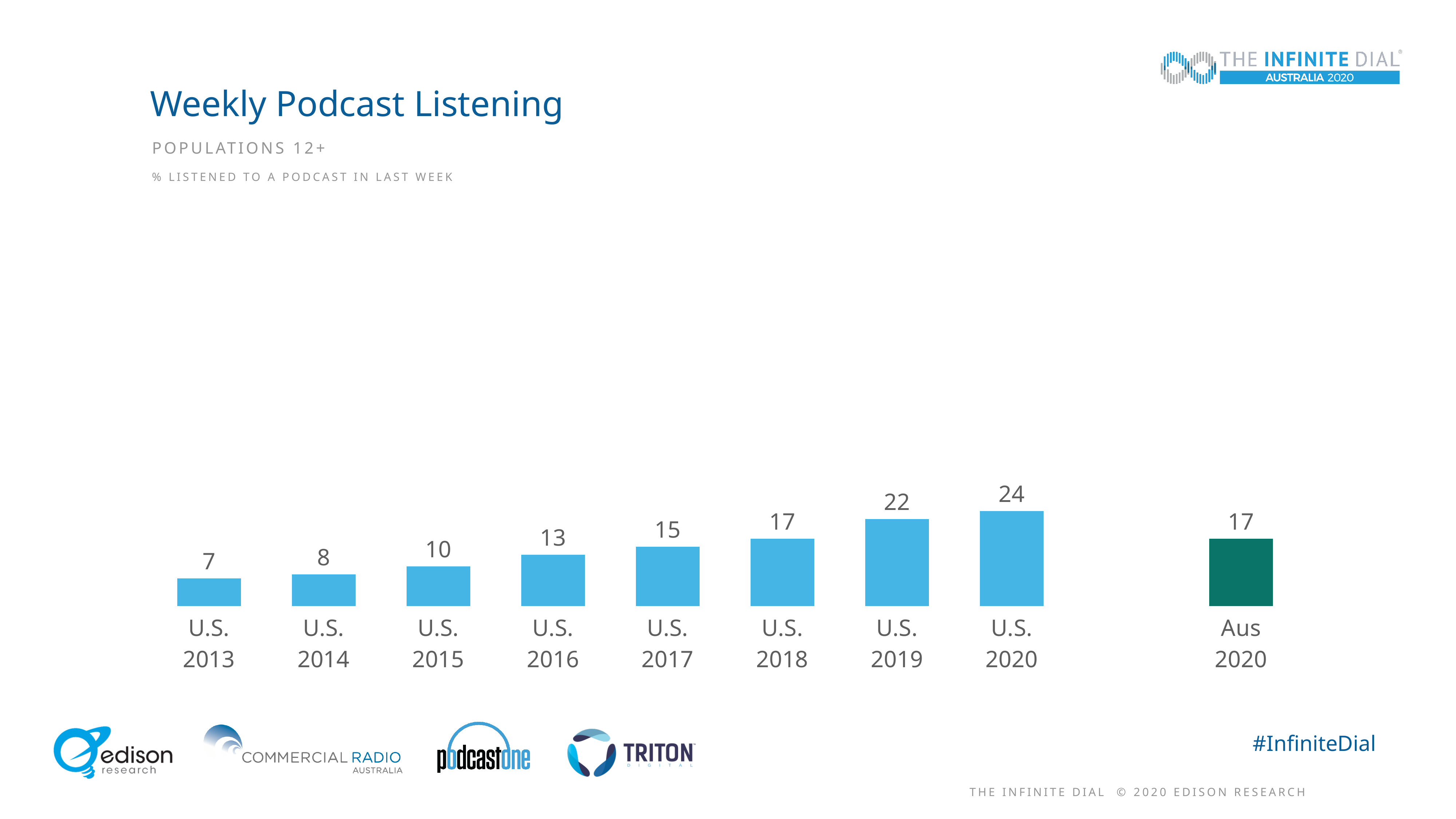
What is the difference between the values for U.S. 2019 and U.S. 2018? 5 What kind of chart is shown on the slide? Bar chart How many bars are shown in the chart? 9 What is the value for Aus 2020? 17 Which is larger, the value for U.S. 2016 or the value for Aus 2020? Aus 2020 Do the U.S. values rise or fall from 2013 to 2020? Rise What is the value for U.S. 2017? 15 What is the title of the chart? Weekly Podcast Listening What is the difference between the values for U.S. 2020 and Aus 2020? 7 Which category has the lowest value? U.S. 2013 Which category has the highest value? U.S. 2020 What is the value for U.S. 2013? 7